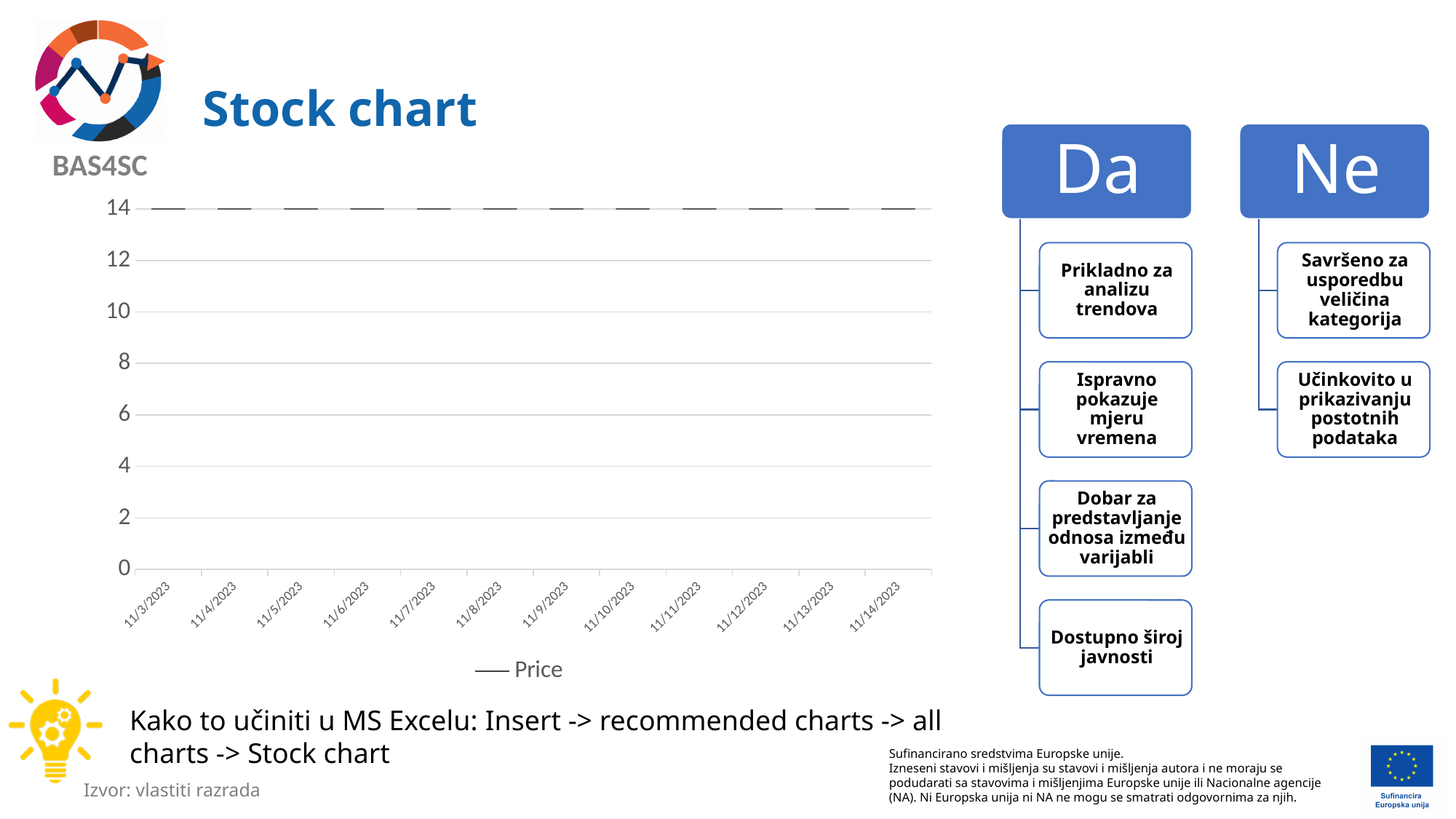
How many series does the chart legend list? 1 How many dates are shown on the x axis of the chart? 12 What is the name of the series in the chart legend? Price Is the value for 11/8/2023 greater or less than 8? greater Is the value for 11/14/2023 greater or less than 10? greater What kind of chart is shown on the slide? stock chart Is the value for 11/3/2023 greater or less than 12? greater What is the title of the slide containing the chart? Stock chart What is the first date shown on the x axis? 11/3/2023